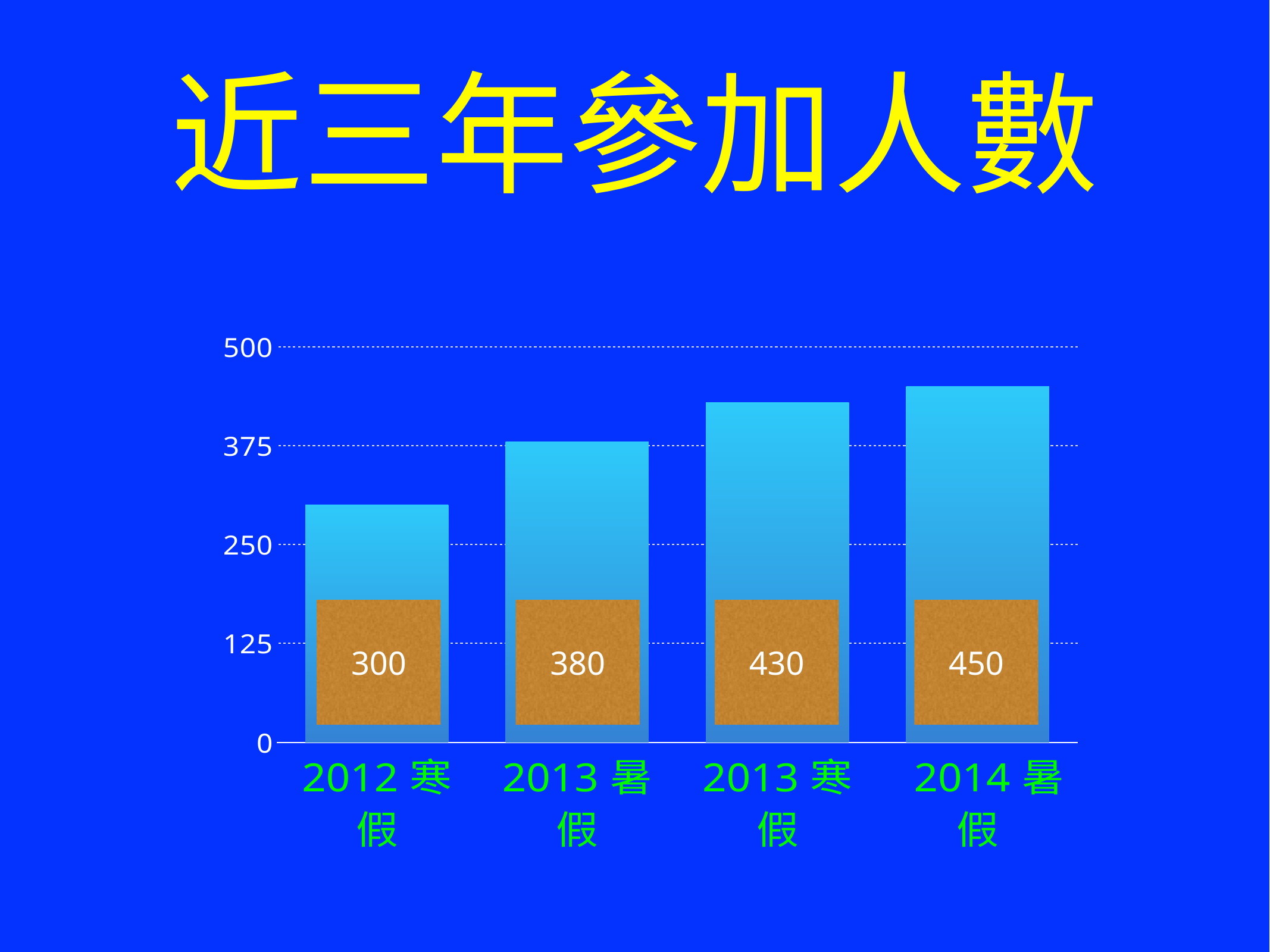
How many categories are shown on the x axis? 4 What is the value for 2014 暑假? 450 Which category has the lowest value? 2012 寒假 Which is larger, the value for 2013 暑假 or the value for 2013 寒假? 2013 寒假 What kind of chart is shown on the slide? bar chart What is the difference between the values for 2013 寒假 and 2013 暑假? 50 Which category has the highest value? 2014 暑假 What is the difference between the values for 2014 暑假 and 2012 寒假? 150 What is the value for 2013 寒假? 430 What is the value for 2013 暑假? 380 What is the value for 2012 寒假? 300 Do the values rise or fall from left to right along the x axis? rise